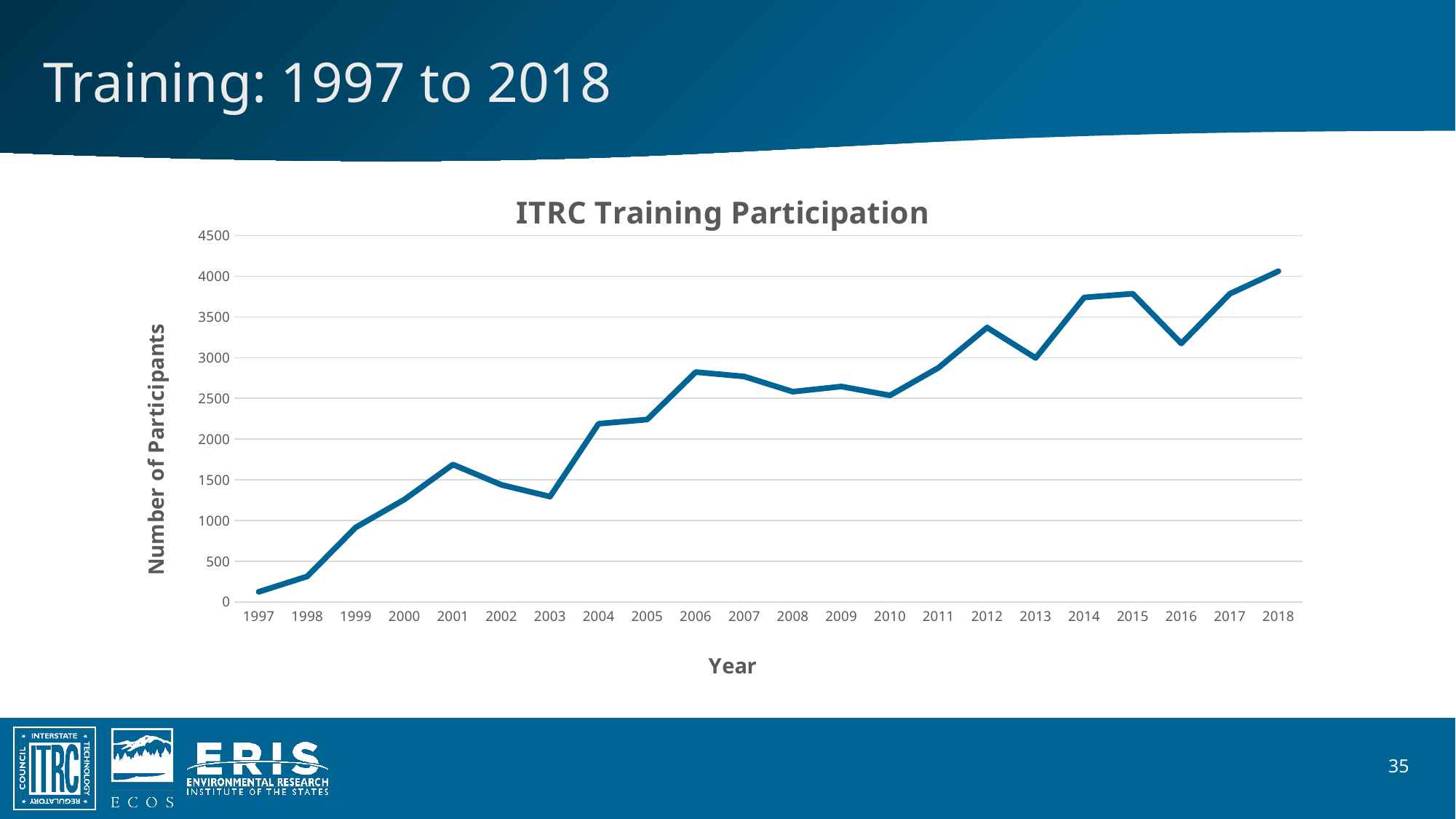
What kind of chart is shown on the slide? line chart Which year has more participants, 2016 or 2017? 2017 What is the label of the vertical axis? Number of Participants Is the value for 2012 greater or less than 3000? greater How many years are plotted on the x axis? 22 Which year has the lowest number of participants? 1997 Which year has the highest number of participants? 2018 Which year has more participants, 2001 or 2003? 2001 Is the value for 2003 greater or less than 1500? less Is the value for 2018 greater or less than 3500? greater Overall, do the number of participants rise or fall from 1997 to 2018? rise What is the title of the chart? ITRC Training Participation